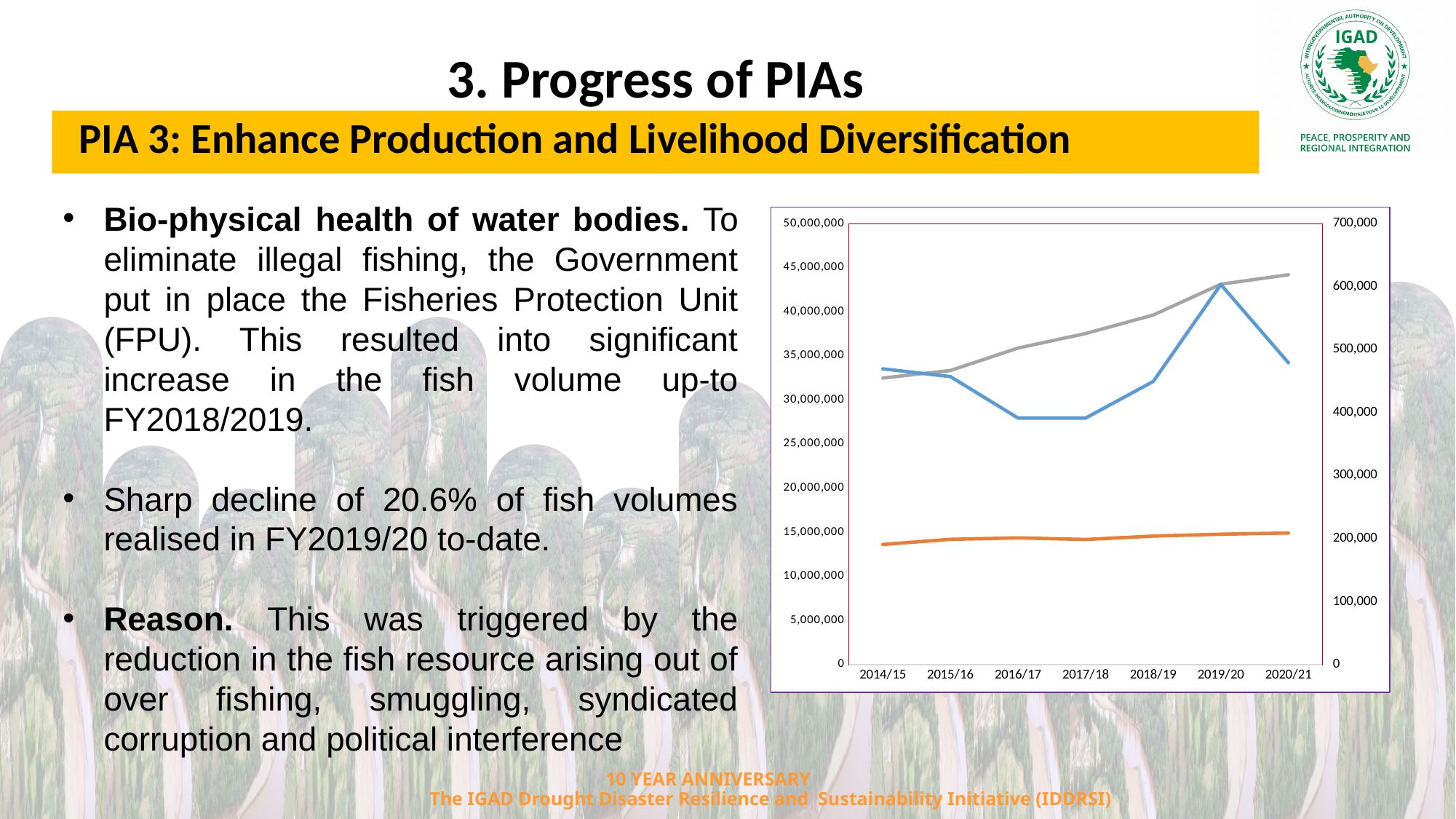
How many lines are plotted on the chart? 3 What kind of chart is shown on the slide? line chart For the blue line, which is higher: 2019/20 or 2020/21? 2019/20 For the blue line, which is higher: 2014/15 or 2016/17? 2014/15 In which fiscal year does the blue line reach its highest point? 2019/20 Does the gray line generally rise or fall from 2014/15 to 2020/21? rise What is the highest value shown on the right vertical axis of the chart? 700,000 How many fiscal years are shown along the x axis of the chart? 7 Does the blue line rise or fall between 2019/20 and 2020/21? fall In which fiscal year is the gray line at its lowest? 2014/15 In which fiscal year does the gray line reach its highest point? 2020/21 What is the highest value shown on the left vertical axis of the chart? 50,000,000